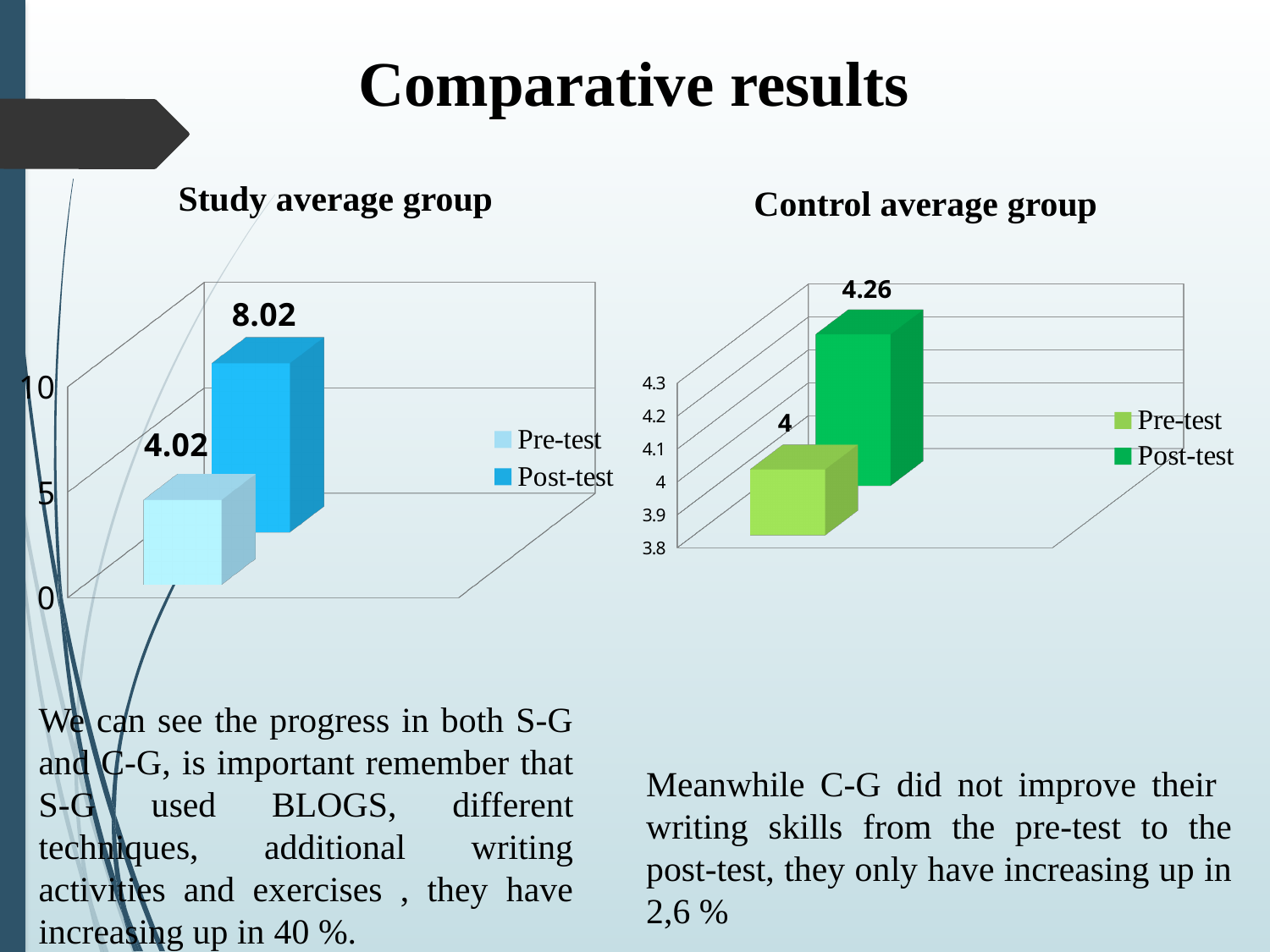
In the Control average group chart, what is the value for Post-test? 4.26 In the Control average group chart, what is the difference between the Post-test and Pre-test values? 0.26 How many series does the legend of the Control average group chart list? 2 In the Study average group chart, is the value for Post-test greater or less than 5? greater In the Control average group chart, which series has the highest value? Post-test In the Control average group chart, what is the value for Pre-test? 4 What kind of chart is the Study average group chart? Bar chart In the Study average group chart, what is the difference between the Post-test and Pre-test values? 4 What colour is the Post-test bar in the Control average group chart? Green In the Study average group chart, what is the value for Pre-test? 4.02 In the Study average group chart, what is the value for Post-test? 8.02 In the Study average group chart, which is larger, Pre-test or Post-test? Post-test